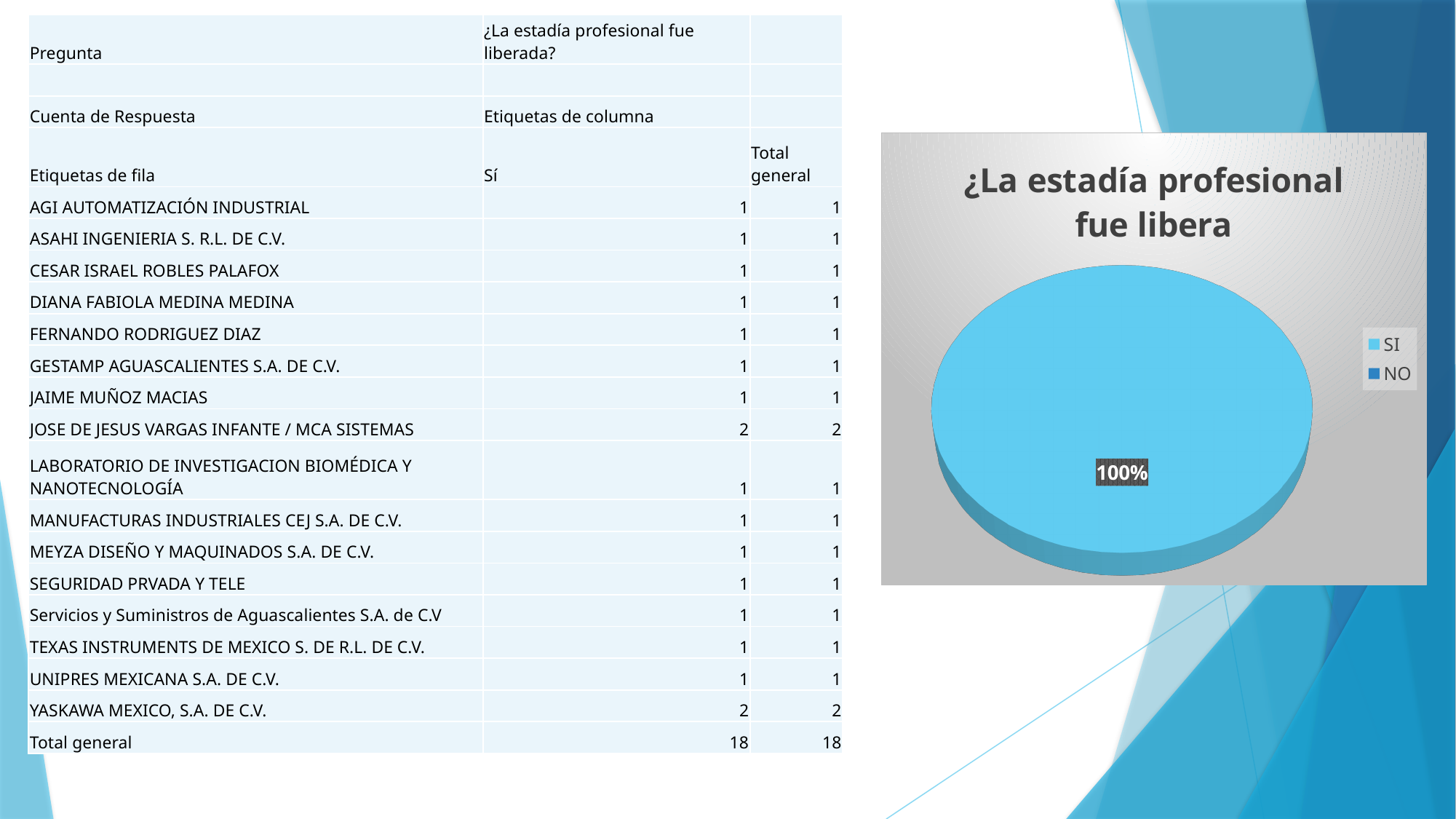
How many entries does the legend of the pie chart list? 2 What are the two legend entries of the pie chart? SI and NO In the pie chart, what share is shown for the SI slice? 100% Is the share for SI in the pie chart greater or less than 50%? greater What kind of chart is shown on the right side of the slide? pie chart Which category has the largest slice in the pie chart? SI What colour is the SI slice in the pie chart? light blue What percentage label is printed on the pie chart? 100%